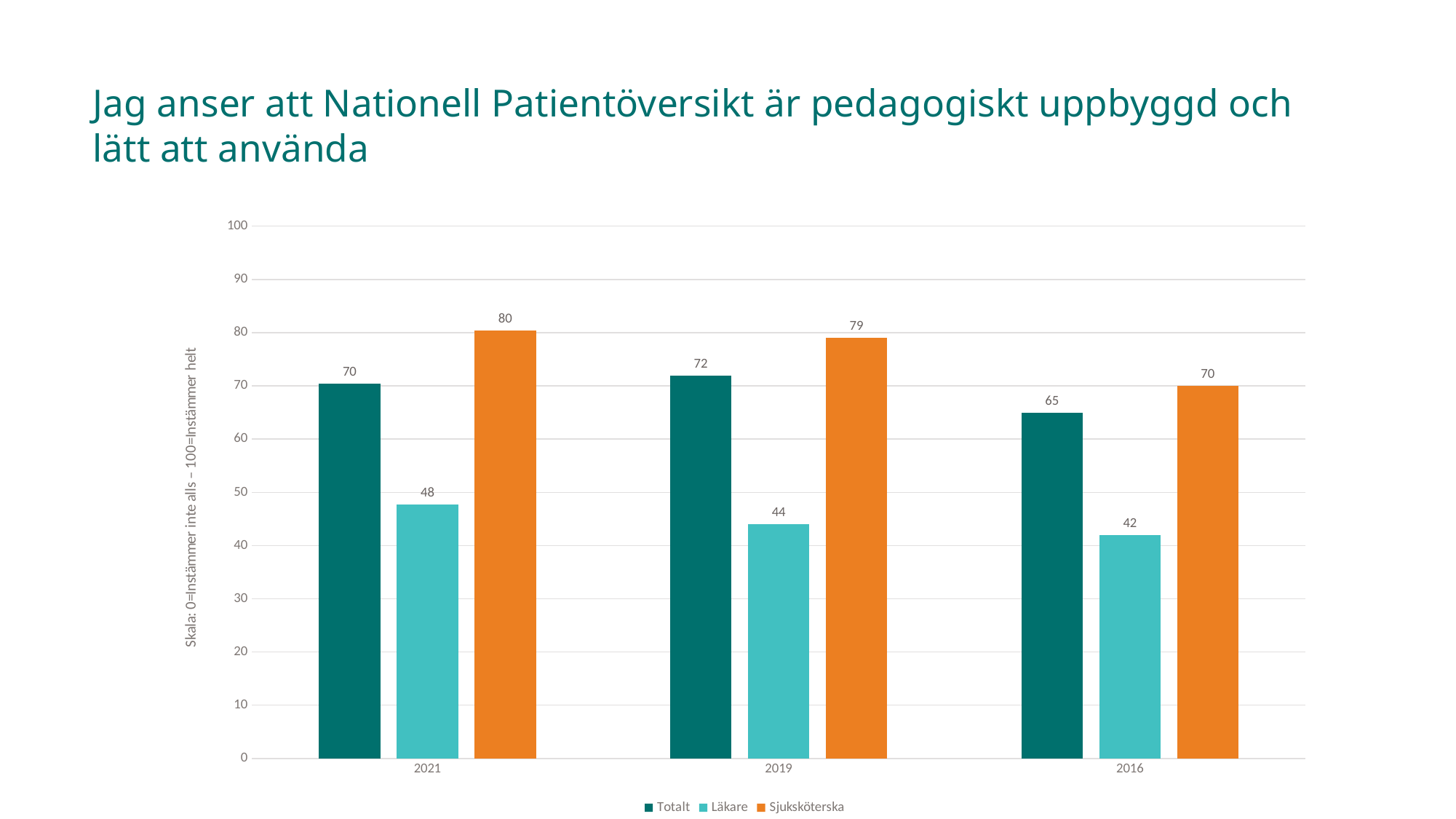
What kind of chart is shown on the slide? Bar chart How many series does the legend list? 3 Which year has the highest value for Läkare? 2021 What is the difference between the Sjuksköterska and Läkare values in 2021? 32 Which is larger in 2019: the value for Totalt or the value for Sjuksköterska? Sjuksköterska What is the value for Totalt in 2016? 65 Which year has the lowest value for Sjuksköterska? 2016 What is the value for Sjuksköterska in 2021? 80 Does the value for Totalt rise or fall from 2021 to 2016 along the x axis? Neither; it rises from 70 to 72 then falls to 65 What is the value for Läkare in 2019? 44 Which series is shown in orange in the legend? Sjuksköterska How many years are shown on the x axis? 3